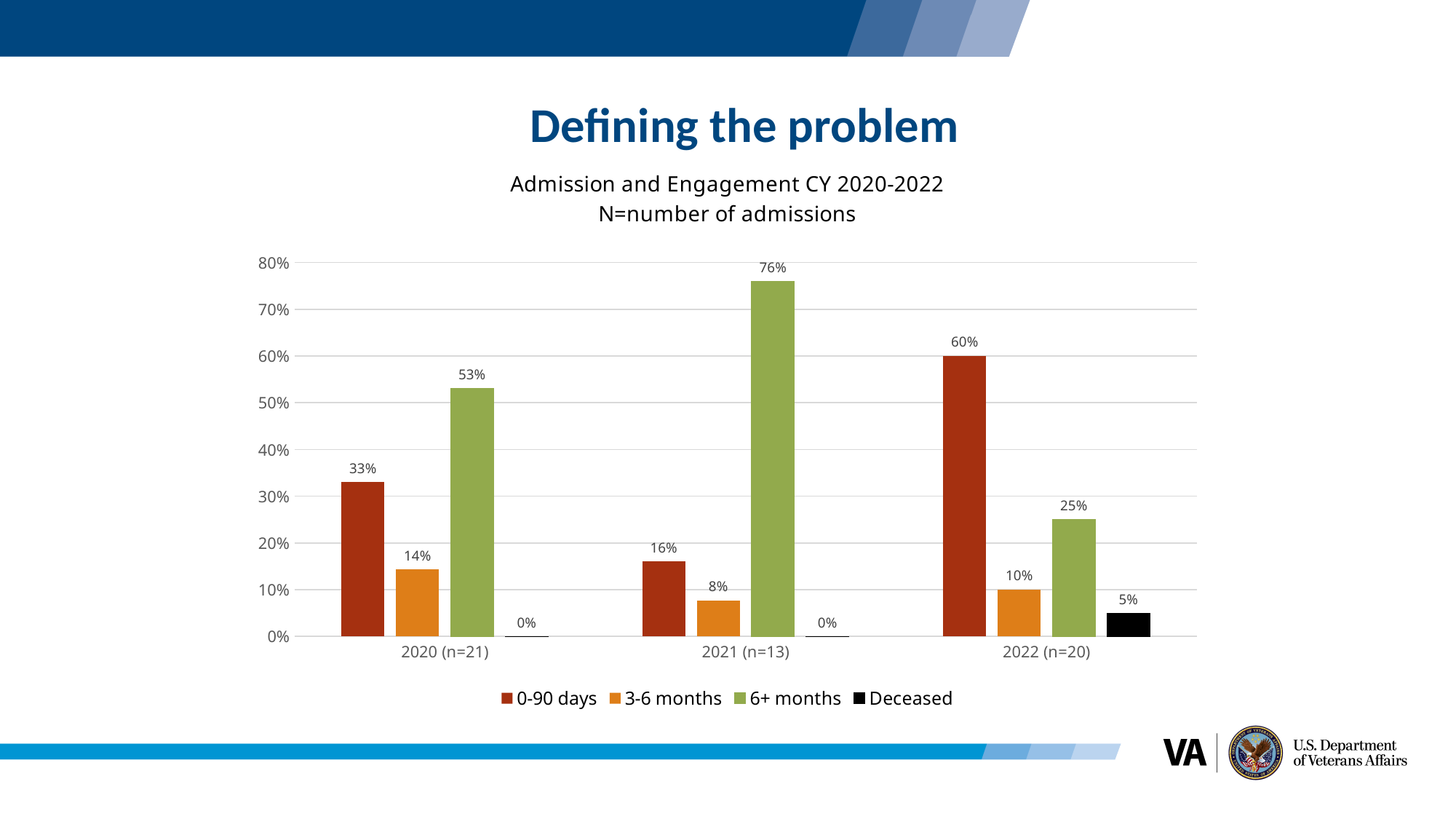
Which is larger in 2020 (n=21): 0-90 days or 6+ months? 6+ months What is the difference between the 0-90 days value and the 6+ months value in 2022 (n=20)? 35% How many series does the legend list? 4 What is the title of the chart? Admission and Engagement CY 2020-2022 N=number of admissions What is the value for 6+ months in 2021 (n=13)? 76% What kind of chart is shown on the slide? Bar chart How many year categories are shown on the x axis? 3 Which year has the lowest value for 0-90 days? 2021 (n=13) Which year has the highest value for 6+ months? 2021 (n=13) What is the value for 0-90 days in 2022 (n=20)? 60% What is the value for 3-6 months in 2020 (n=21)? 14% What is the value for Deceased in 2022 (n=20)? 5%